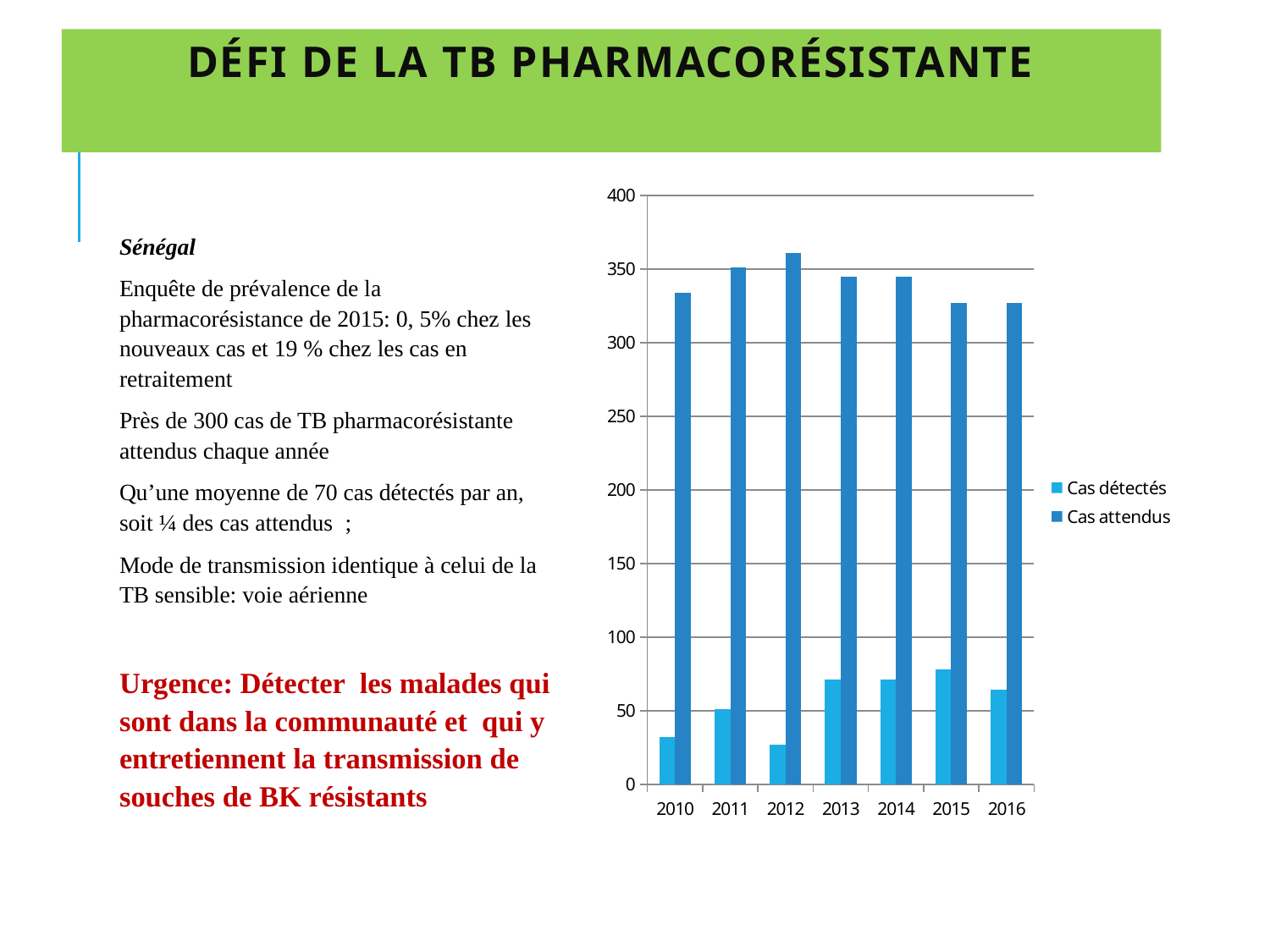
Is the value for Cas attendus in 2010 greater or less than 350? less How many years are shown on the x axis of the chart? 7 Which year has the highest value for Cas attendus? 2012 What kind of chart is shown on the slide? bar chart Which year has the lowest value for Cas détectés? 2012 Which year has the highest value for Cas détectés? 2015 Which is larger, Cas détectés in 2011 or Cas détectés in 2012? 2011 How many series does the legend list? 2 Is the value for Cas détectés in 2012 greater or less than 50? less What are the two entries listed in the chart legend? Cas détectés and Cas attendus Is the value for Cas détectés in 2015 greater or less than 50? greater